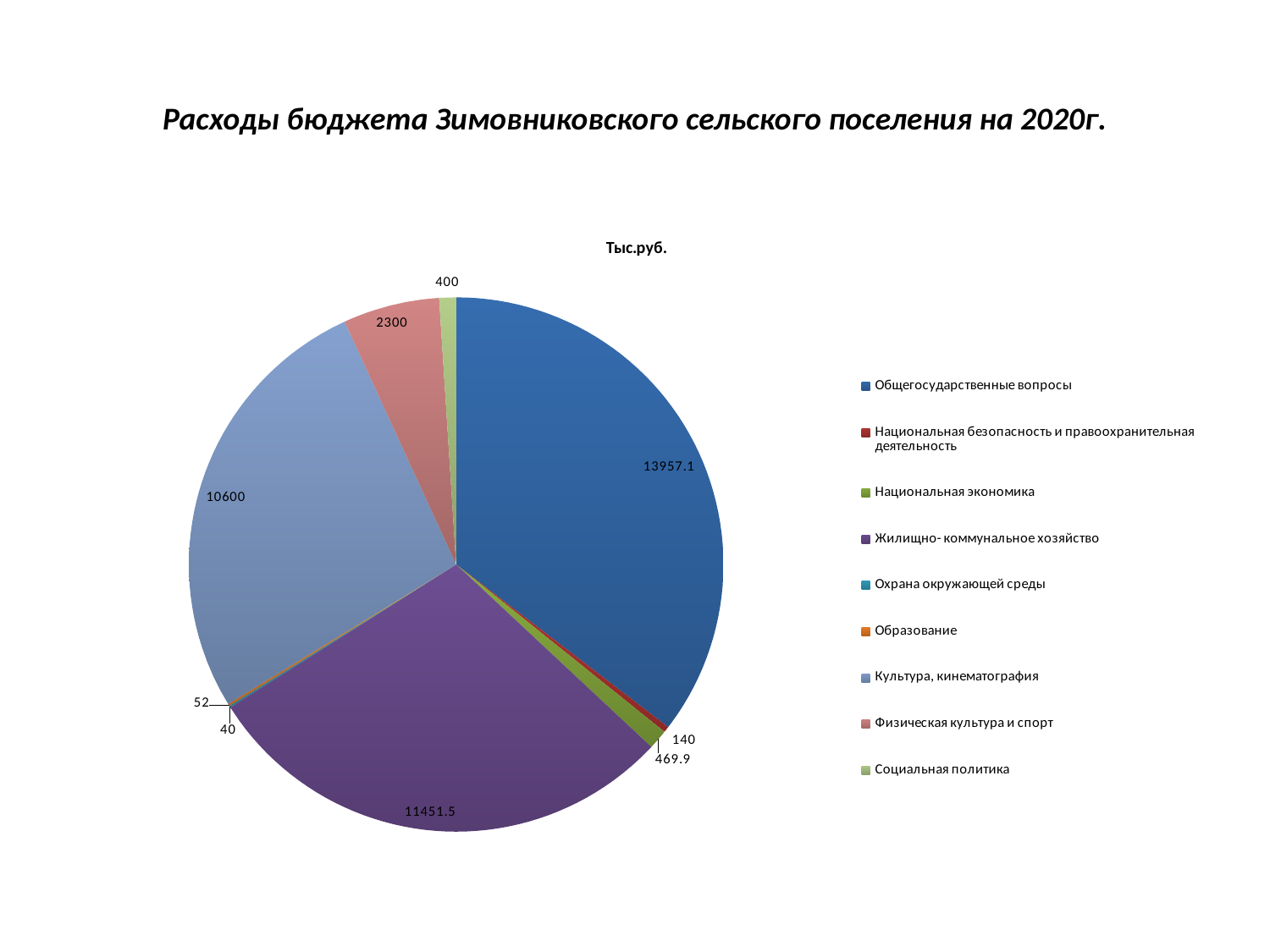
What is the value for Культура, кинематография? 10600 What is the value for Физическая культура и спорт? 2300 What type of chart is shown on the slide? pie chart What is the title shown above the pie chart? Тыс.руб. What is the value for Общегосударственные вопросы? 13957.1 What is the value for Национальная экономика? 469.9 What is the difference between the values for Культура, кинематография and Физическая культура и спорт? 8300 What is the difference between the values for Общегосударственные вопросы and Жилищно- коммунальное хозяйство? 2505.6 What is the value for Жилищно- коммунальное хозяйство? 11451.5 Which category has the largest slice of the pie? Общегосударственные вопросы Which is larger, the value for Социальная политика or the value for Национальная безопасность и правоохранительная деятельность? Социальная политика How many categories does the pie chart have? 9